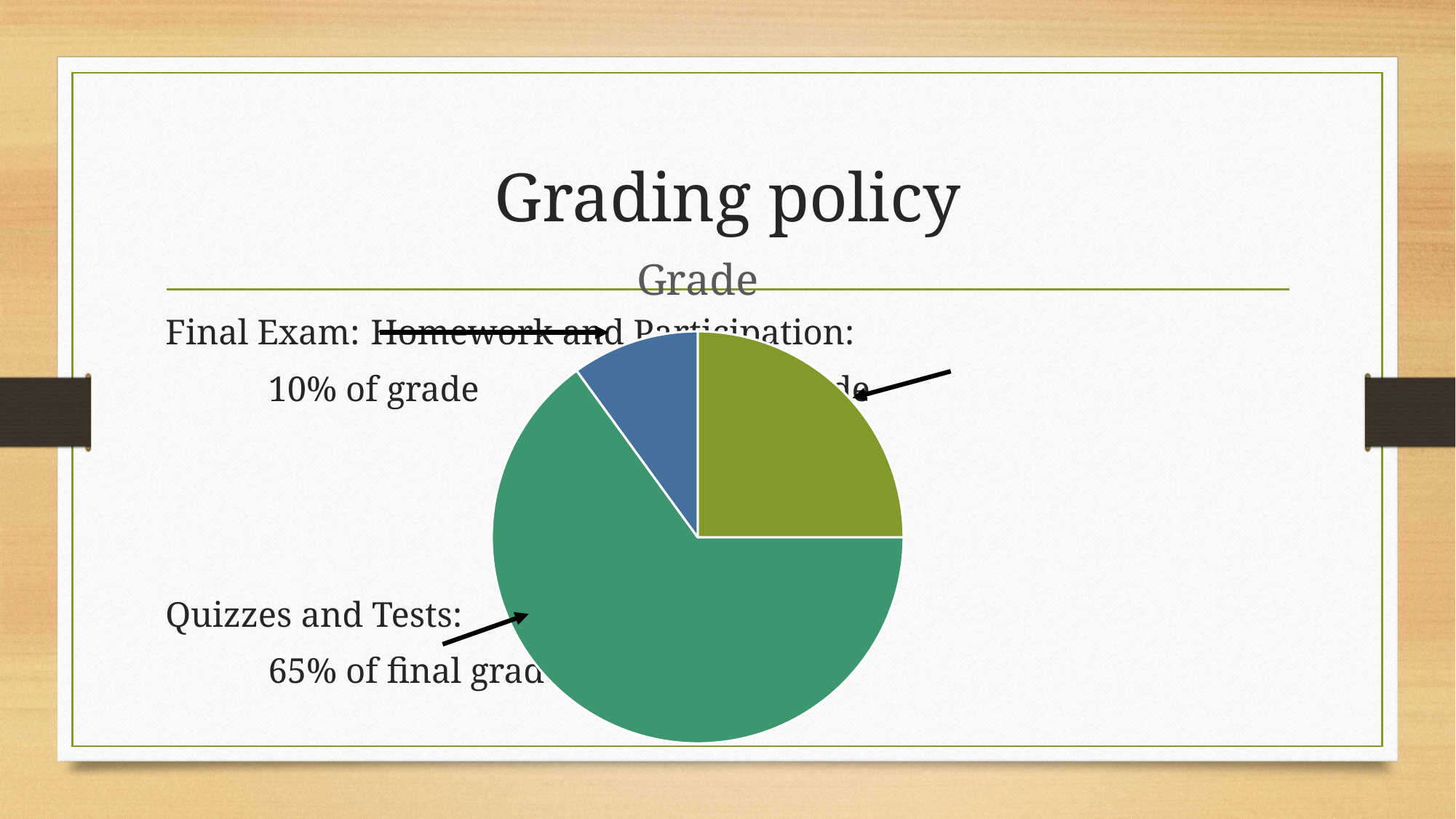
Which grade component has the smallest slice of the pie chart? Final Exam How many slices does the pie chart have? 3 What share of the final grade does the Quizzes and Tests slice represent? 65% What is the title of the pie chart? Grade What colour is the largest slice of the pie chart? green What share of the grade does the Final Exam slice represent? 10% Which slice is larger, Homework and Participation or Final Exam? Homework and Participation Is the share for the largest slice greater or less than 50%? greater What is the difference between the Quizzes and Tests share and the Final Exam share? 55% What kind of chart is shown on the slide? pie chart Which grade component has the largest slice of the pie chart? Quizzes and Tests